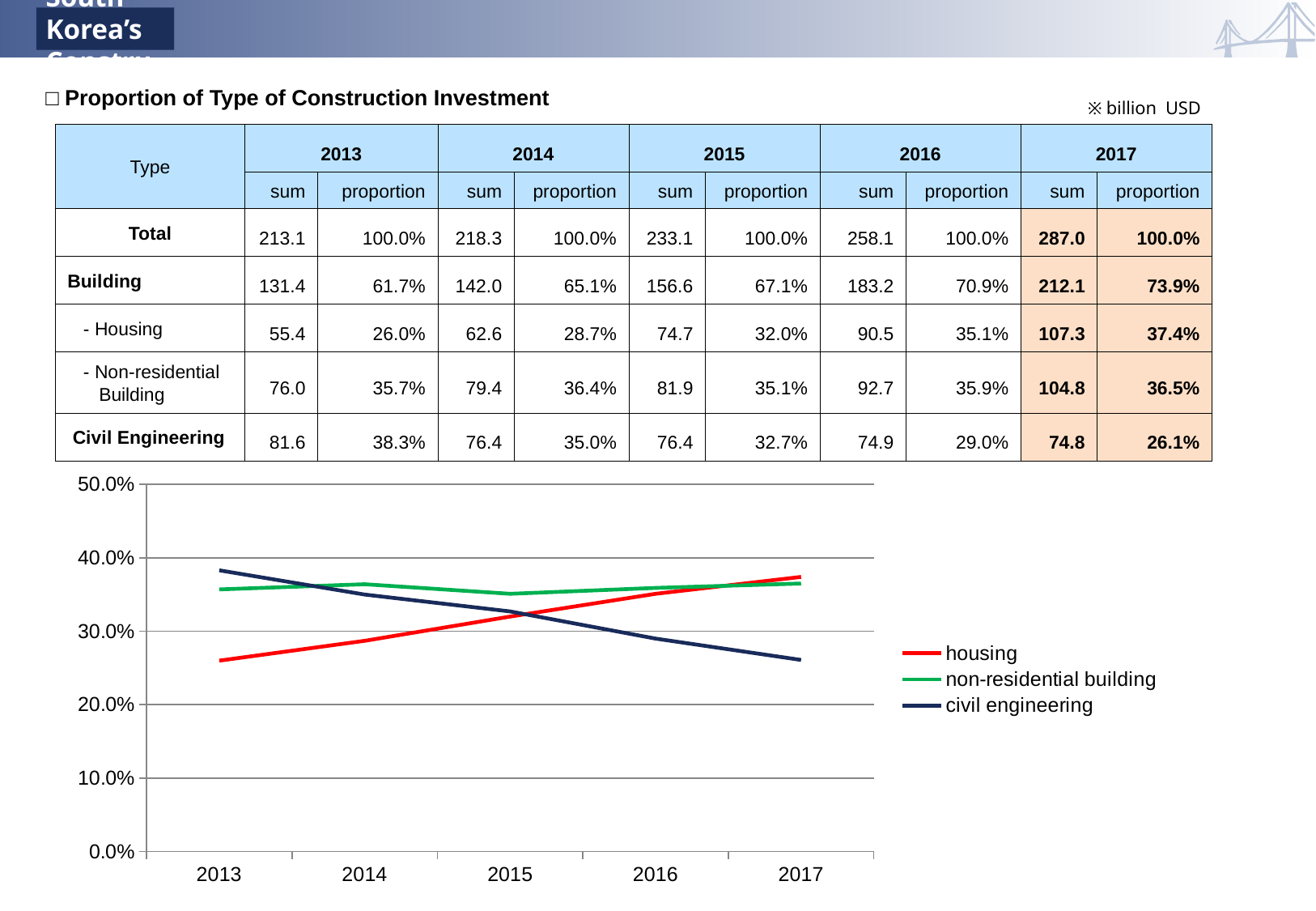
In 2017, which is higher on the chart: housing or civil engineering? housing In 2013, which is higher on the chart: civil engineering or housing? civil engineering What colour is the housing line in the chart? red How many years are plotted along the x axis of the chart? 5 Which series has the lowest value in 2017? civil engineering How many series does the chart's legend list? 3 What kind of chart is shown below the table? line chart Is the housing value for 2013 greater or less than 30.0%? less Does the housing line rise or fall from 2013 to 2017? rises Does the civil engineering line rise or fall from 2013 to 2017? falls Which series has the highest value in 2013? civil engineering Is the civil engineering value for 2013 greater or less than 30.0%? greater